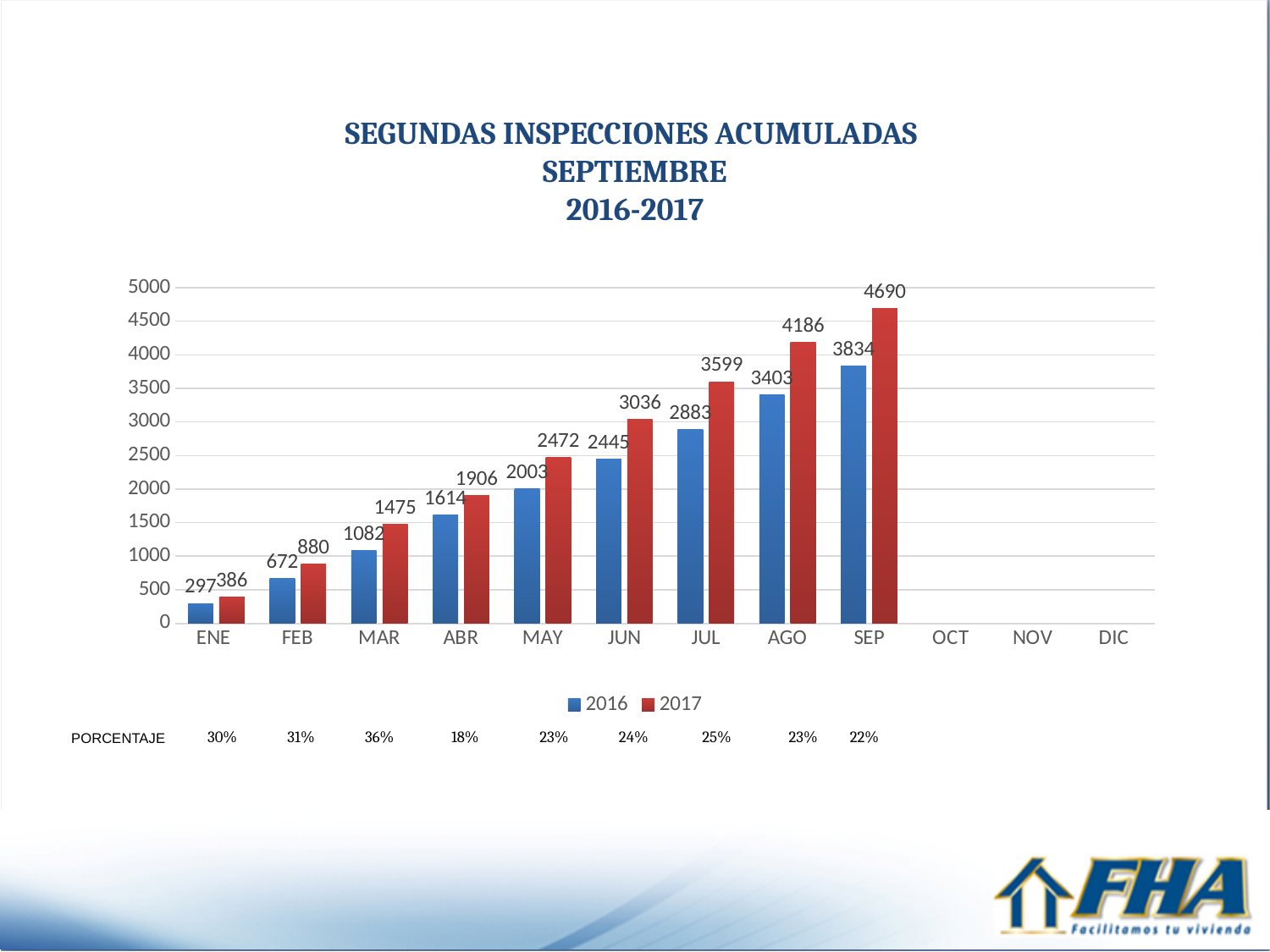
What is the value for 2016 in MAR? 1082 How many series does the legend list? 2 What is the value for 2017 in ABR? 1906 What is the difference between the 2017 and 2016 values in AGO? 783 What kind of chart is shown? Bar chart Which month has the highest value for the 2016 series? SEP What is the value for 2017 in SEP? 4690 Do the 2017 values rise or fall from ENE to SEP? Rise Which month has the lowest value for the 2017 series? ENE How many months on the x axis have bars plotted? 9 Which is larger in JUN: the 2016 value or the 2017 value? 2017 What colour are the bars for the 2016 series? Blue